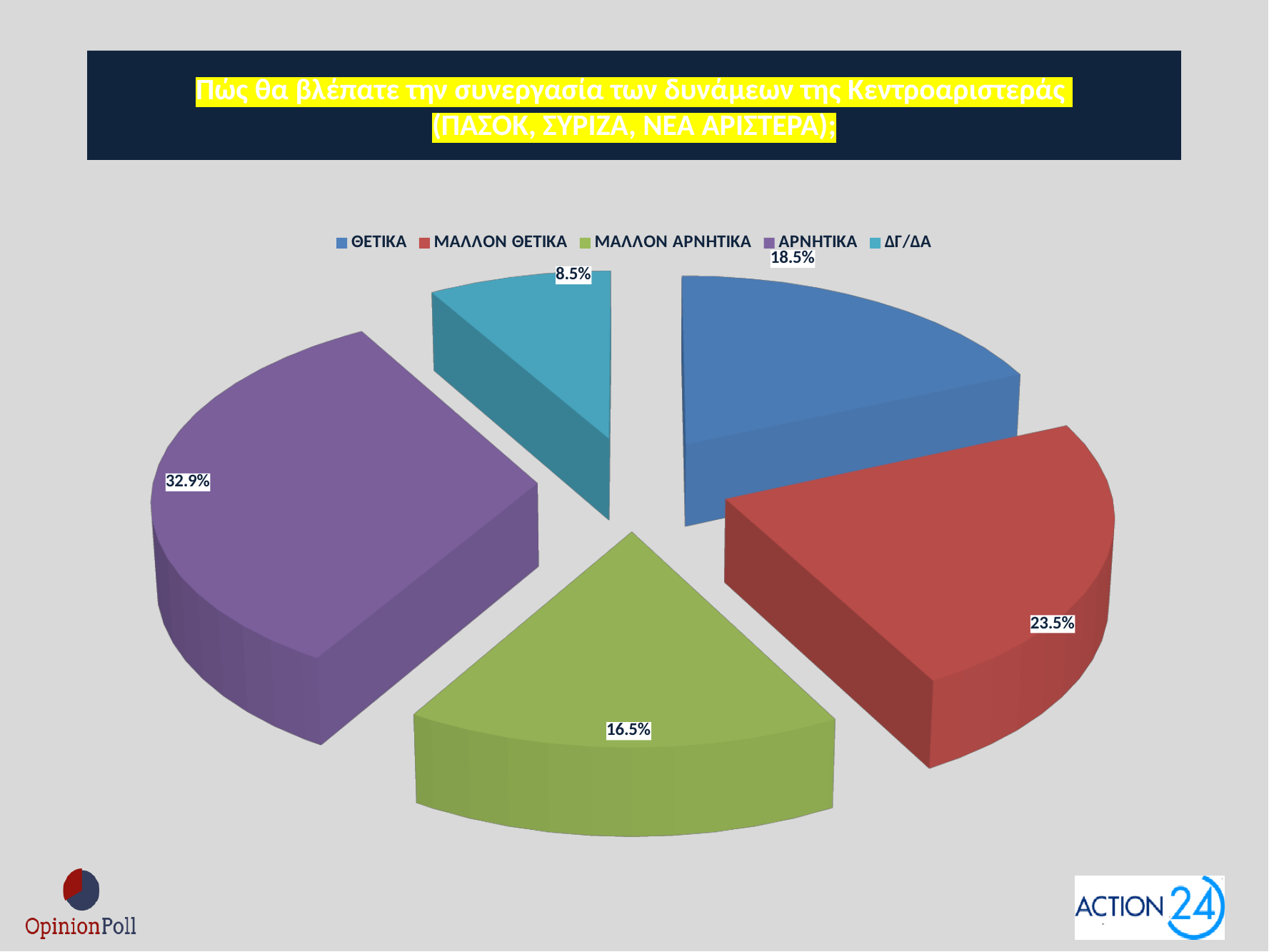
What colour is the ΑΡΝΗΤΙΚΑ slice? Purple Which is larger, ΜΑΛΛΟΝ ΘΕΤΙΚΑ or ΜΑΛΛΟΝ ΑΡΝΗΤΙΚΑ? ΜΑΛΛΟΝ ΘΕΤΙΚΑ What percentage is shown for ΘΕΤΙΚΑ? 18.5% What percentage is shown for ΜΑΛΛΟΝ ΘΕΤΙΚΑ? 23.5% Which category has the smallest share of the pie? ΔΓ/ΔΑ What percentage is shown for ΑΡΝΗΤΙΚΑ? 32.9% What percentage is shown for ΜΑΛΛΟΝ ΑΡΝΗΤΙΚΑ? 16.5% How many categories does the legend list? 5 What is the difference in percentage points between ΑΡΝΗΤΙΚΑ and ΘΕΤΙΚΑ? 14.4 Which category has the largest share of the pie? ΑΡΝΗΤΙΚΑ What percentage is shown for ΔΓ/ΔΑ? 8.5% What kind of chart is shown on the slide? Pie chart